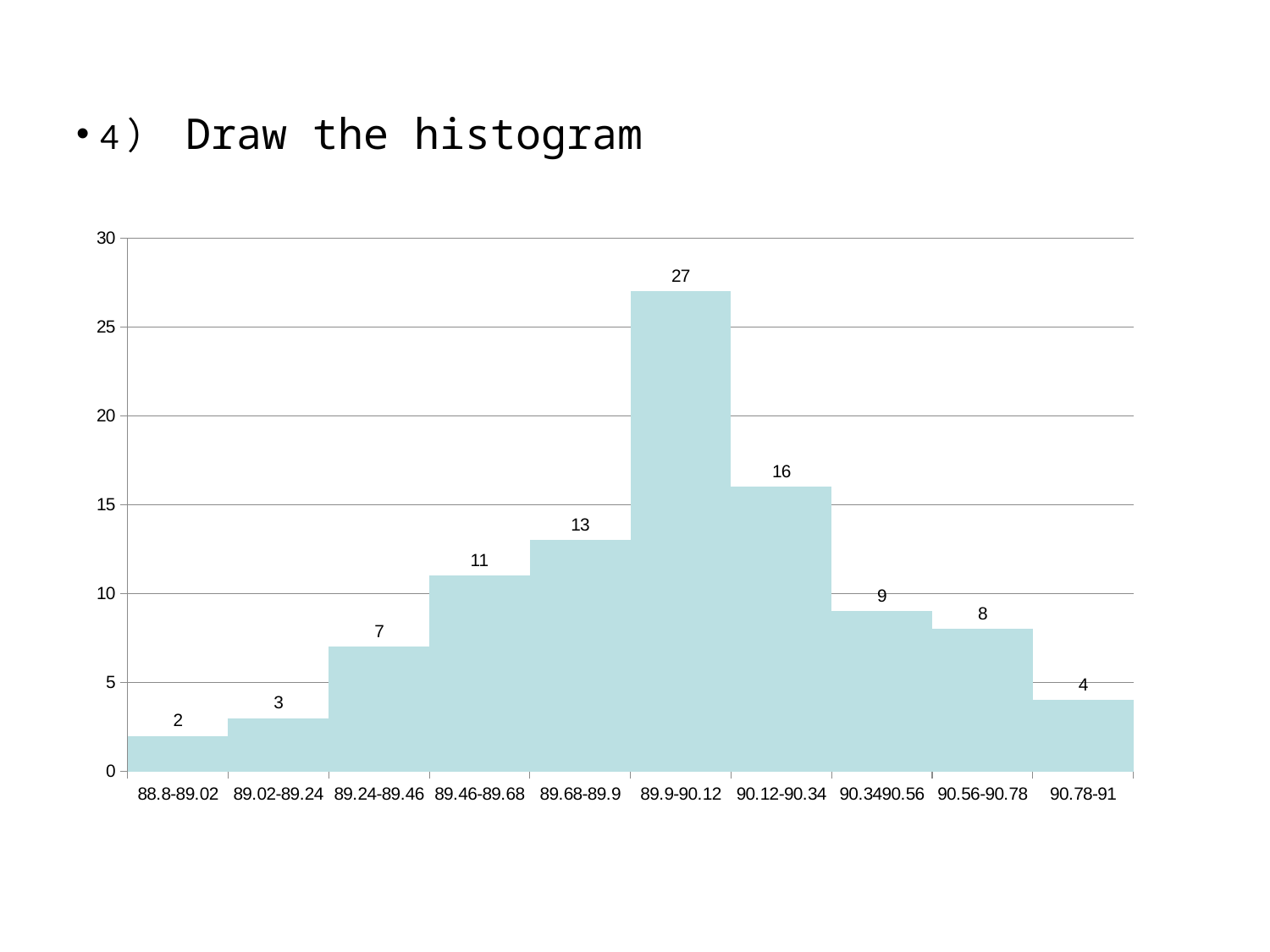
Which bin has the highest value? 89.9-90.12 What kind of chart is shown on the slide? bar chart (histogram) Which is larger, the value for 89.46-89.68 or the value for 90.56-90.78? 89.46-89.68 What is the value for the 90.56-90.78 bin? 8 What is the value for the 88.8-89.02 bin? 2 Which bin has the lowest value? 88.8-89.02 Do the values rise or fall from the 88.8-89.02 bin to the 89.9-90.12 bin? rise What is the value for the 89.9-90.12 bin? 27 What is the difference between the values for the 89.9-90.12 bin and the 90.12-90.34 bin? 11 Is the value for the 89.68-89.9 bin greater or less than 10? greater What is the total of all the bar values in the histogram? 100 How many bins are shown on the x axis? 10